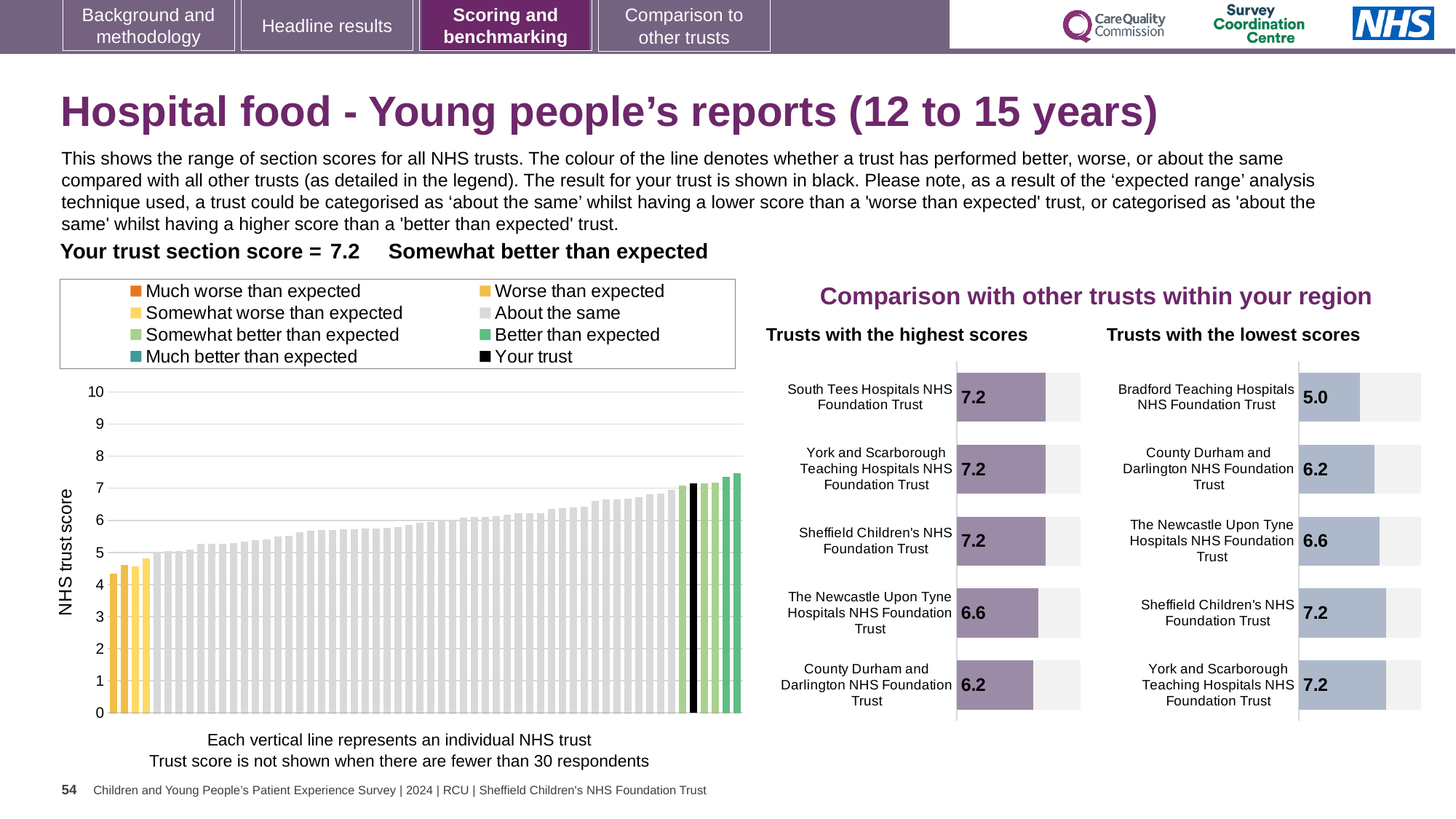
In the 'Trusts with the lowest scores' chart, which trust has the lowest score? Bradford Teaching Hospitals NHS Foundation Trust In the 'Trusts with the highest scores' chart, what is the score for South Tees Hospitals NHS Foundation Trust? 7.2 In the 'Trusts with the lowest scores' chart, what is the score for Bradford Teaching Hospitals NHS Foundation Trust? 5.0 In the 'Trusts with the highest scores' chart, what is the score for The Newcastle Upon Tyne Hospitals NHS Foundation Trust? 6.6 In the NHS trust score chart on the left, do the bar values rise or fall from left to right? rise In the 'Trusts with the highest scores' chart, which trust has the lowest score? County Durham and Darlington NHS Foundation Trust How many entries does the legend of the NHS trust score chart on the left list? 8 How many trusts are shown in the 'Trusts with the highest scores' chart? 5 In the 'Trusts with the lowest scores' chart, which has the higher score: The Newcastle Upon Tyne Hospitals NHS Foundation Trust or County Durham and Darlington NHS Foundation Trust? The Newcastle Upon Tyne Hospitals NHS Foundation Trust In the NHS trust score chart on the left, is the value of the leftmost bar greater or less than 5? less In the 'Trusts with the highest scores' chart, what is the difference between the scores of South Tees Hospitals NHS Foundation Trust and The Newcastle Upon Tyne Hospitals NHS Foundation Trust? 0.6 In the 'Trusts with the lowest scores' chart, what is the difference between the scores of County Durham and Darlington NHS Foundation Trust and Bradford Teaching Hospitals NHS Foundation Trust? 1.2